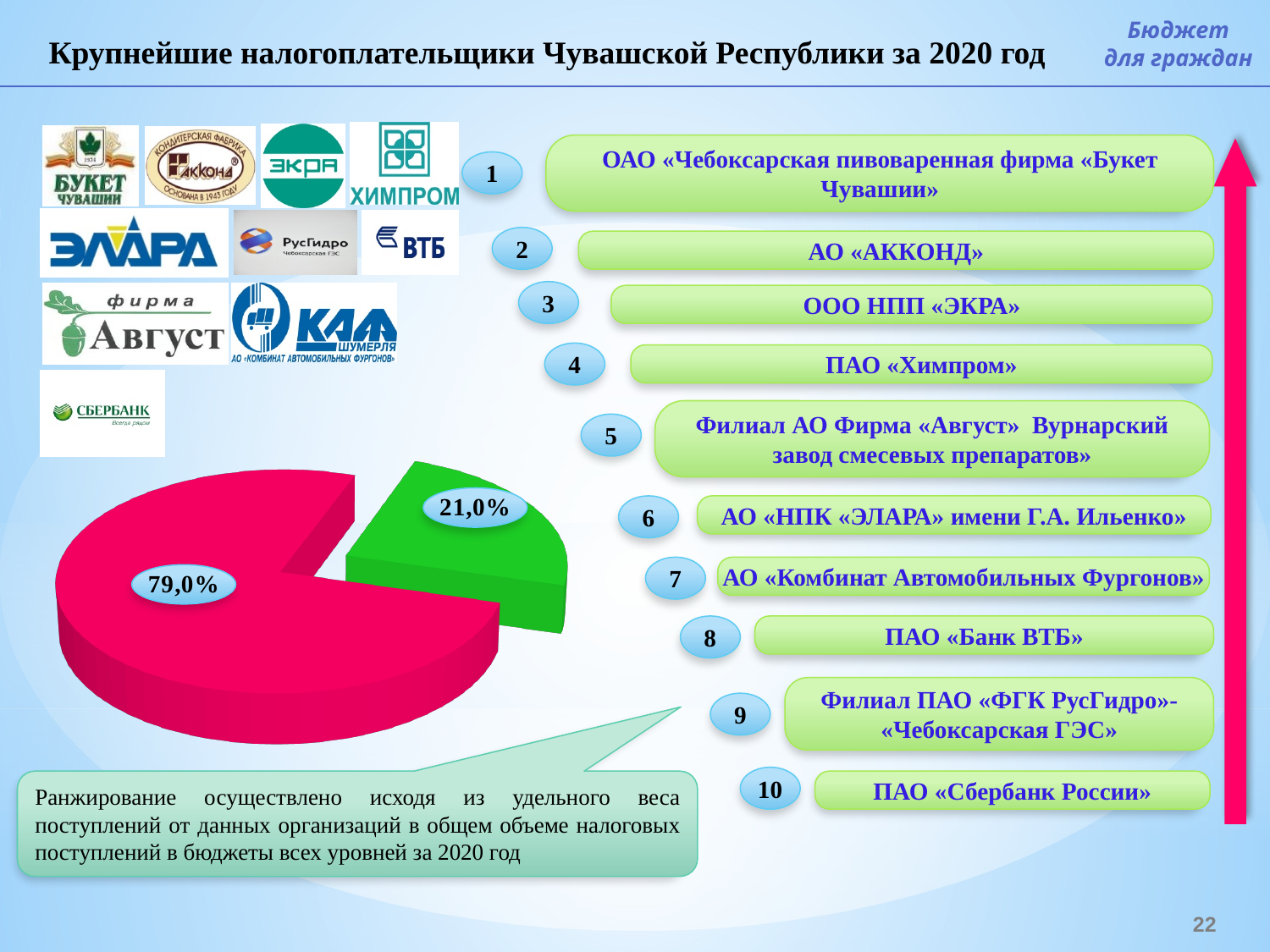
What colour is the slice labelled 79,0% on the pie chart? pink What value is shown on the large pink slice of the pie chart? 79,0% What do the two values on the pie chart add up to? 100,0% What kind of chart is shown on the slide? pie chart Is the value of the green slice of the pie chart greater or less than 25%? less Which slice of the pie chart is pulled out (exploded) from the rest? the green slice Which slice of the pie chart is larger, the pink one or the green one? the pink one What is the largest value shown on the pie chart? 79,0% What value is shown on the green slice of the pie chart? 21,0% How many slices does the pie chart have? 2 What is the smallest value shown on the pie chart? 21,0% What is the difference between the two values shown on the pie chart? 58,0%